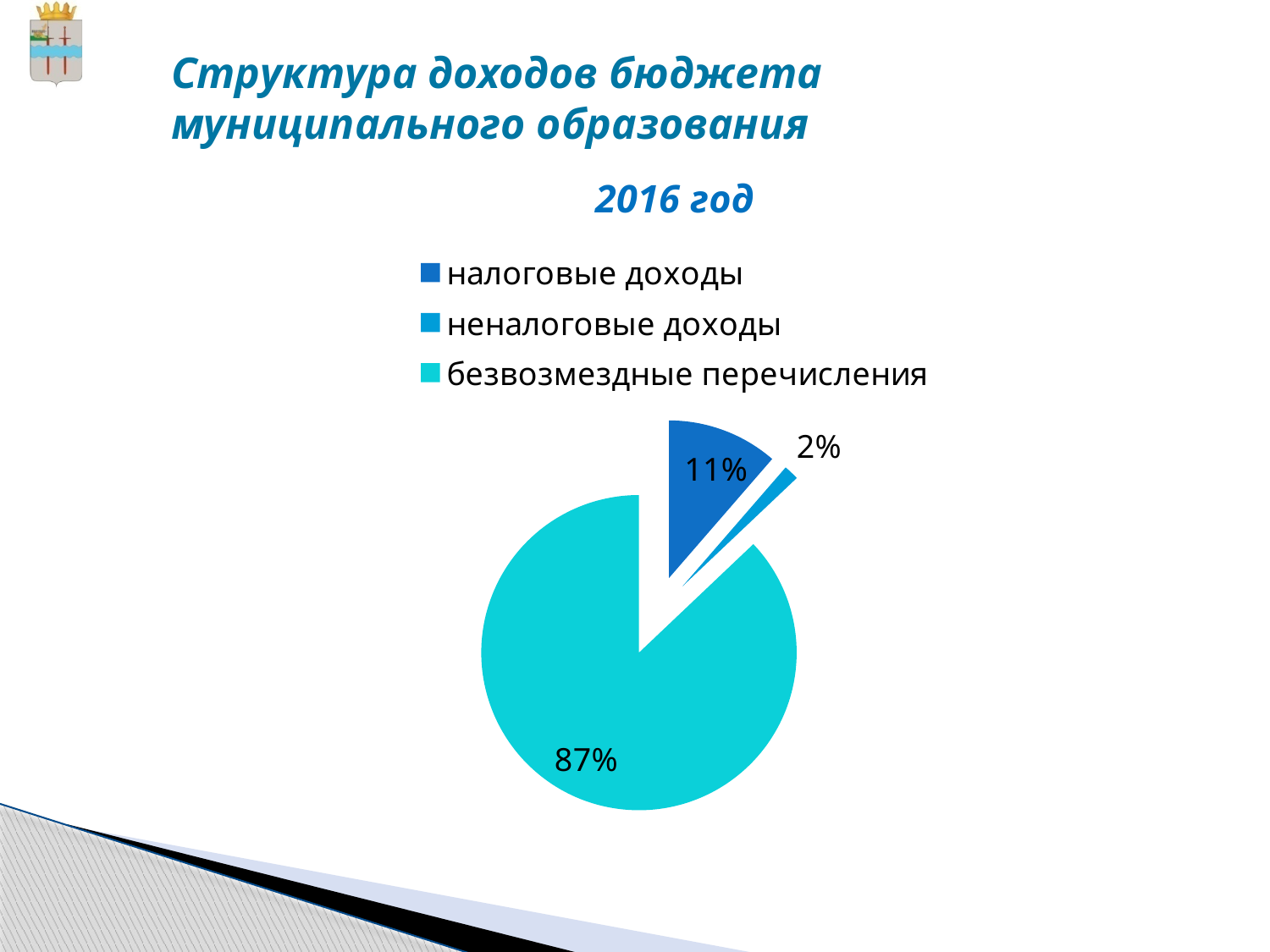
What share of the pie does безвозмездные перечисления have? 87% How many entries does the legend list? 3 Which year does the chart title refer to? 2016 год How many slices does the pie chart have? 3 What is the difference in percentage points between безвозмездные перечисления and налоговые доходы? 76 What share of the pie does налоговые доходы have? 11% Which category has the smallest slice of the pie? неналоговые доходы Which is larger, налоговые доходы or неналоговые доходы? налоговые доходы What is the difference in percentage points between налоговые доходы and неналоговые доходы? 9 What kind of chart is shown on the slide? pie chart Which category has the largest slice of the pie? безвозмездные перечисления What share of the pie does неналоговые доходы have? 2%